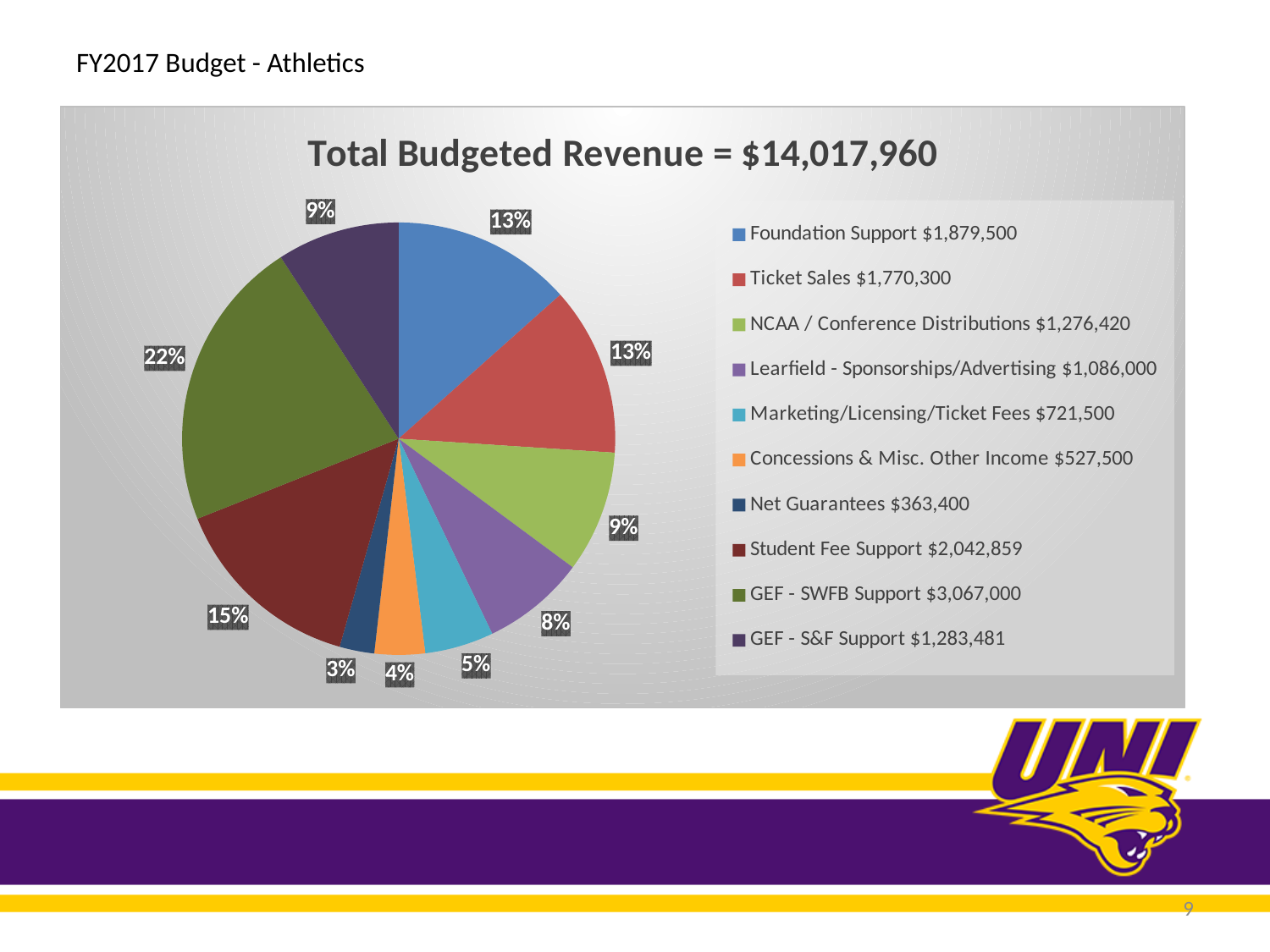
What share of the pie does Student Fee Support represent? 15% What is the budgeted amount for GEF - SWFB Support? $3,067,000 How many categories does the pie chart have? 10 Which category has the smallest share of the pie? Net Guarantees What is the title of the chart? Total Budgeted Revenue = $14,017,960 What type of chart is shown on the slide? pie chart What is the budgeted amount for Net Guarantees? $363,400 What share of the pie does GEF - SWFB Support represent? 22% What is the budgeted amount for Ticket Sales? $1,770,300 Which category has the largest share of the pie? GEF - SWFB Support What is the difference between the Foundation Support amount and the Ticket Sales amount? $109,200 Which is larger, the amount for Learfield - Sponsorships/Advertising or the amount for Marketing/Licensing/Ticket Fees? Learfield - Sponsorships/Advertising